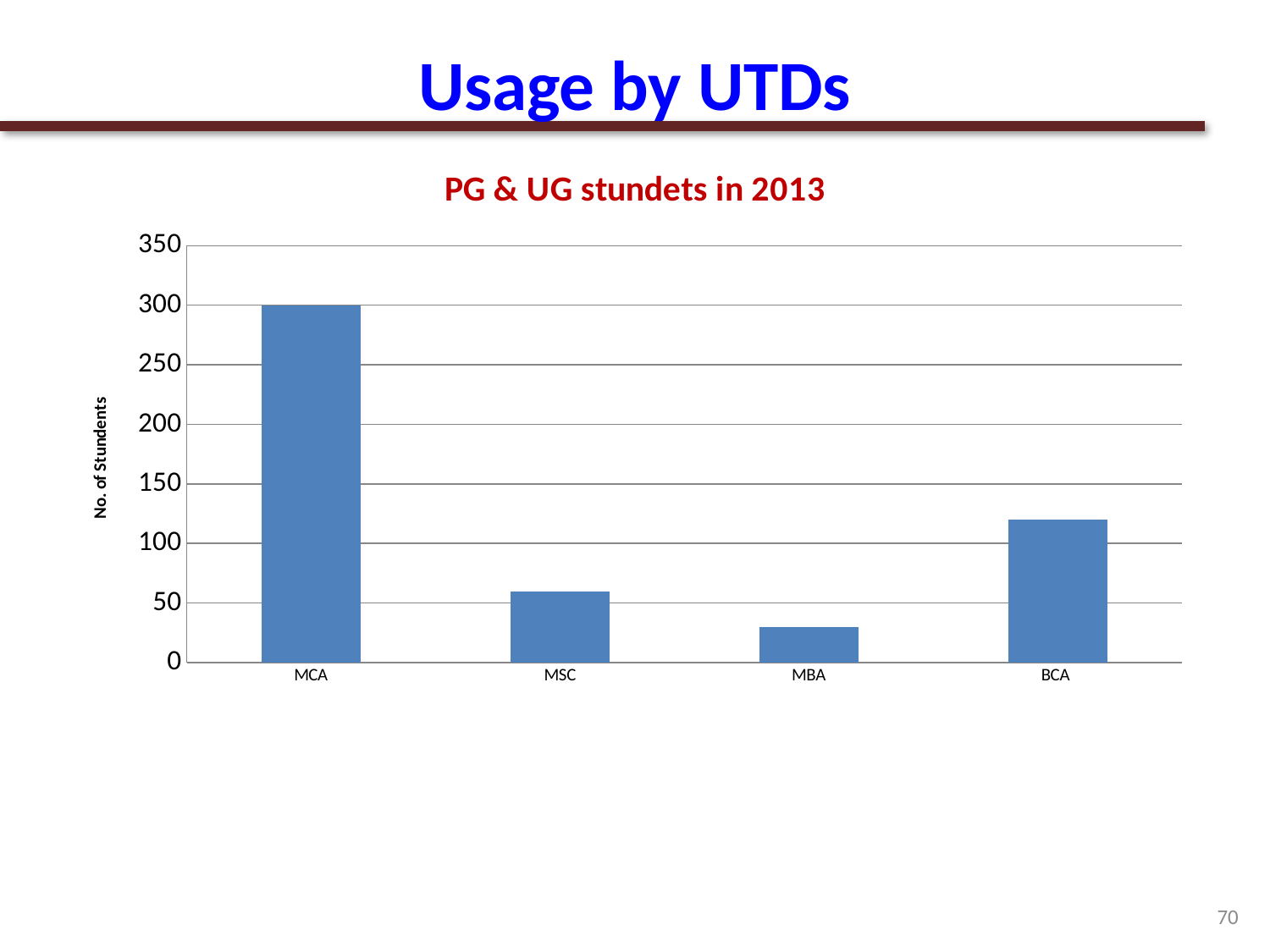
What is the value for MCA in the chart? 300 What kind of chart is shown on the slide? bar chart Is the value for MBA greater or less than 50? less How many categories are shown on the x axis of the chart? 4 Which category has the highest number of students? MCA Is the value for BCA greater or less than 100? greater What is the title of the chart? PG & UG stundets in 2013 Is the value for MSC greater or less than 100? less Which category has the lowest number of students? MBA Which has more students, MSC or MBA? MSC Which has more students, MSC or BCA? BCA